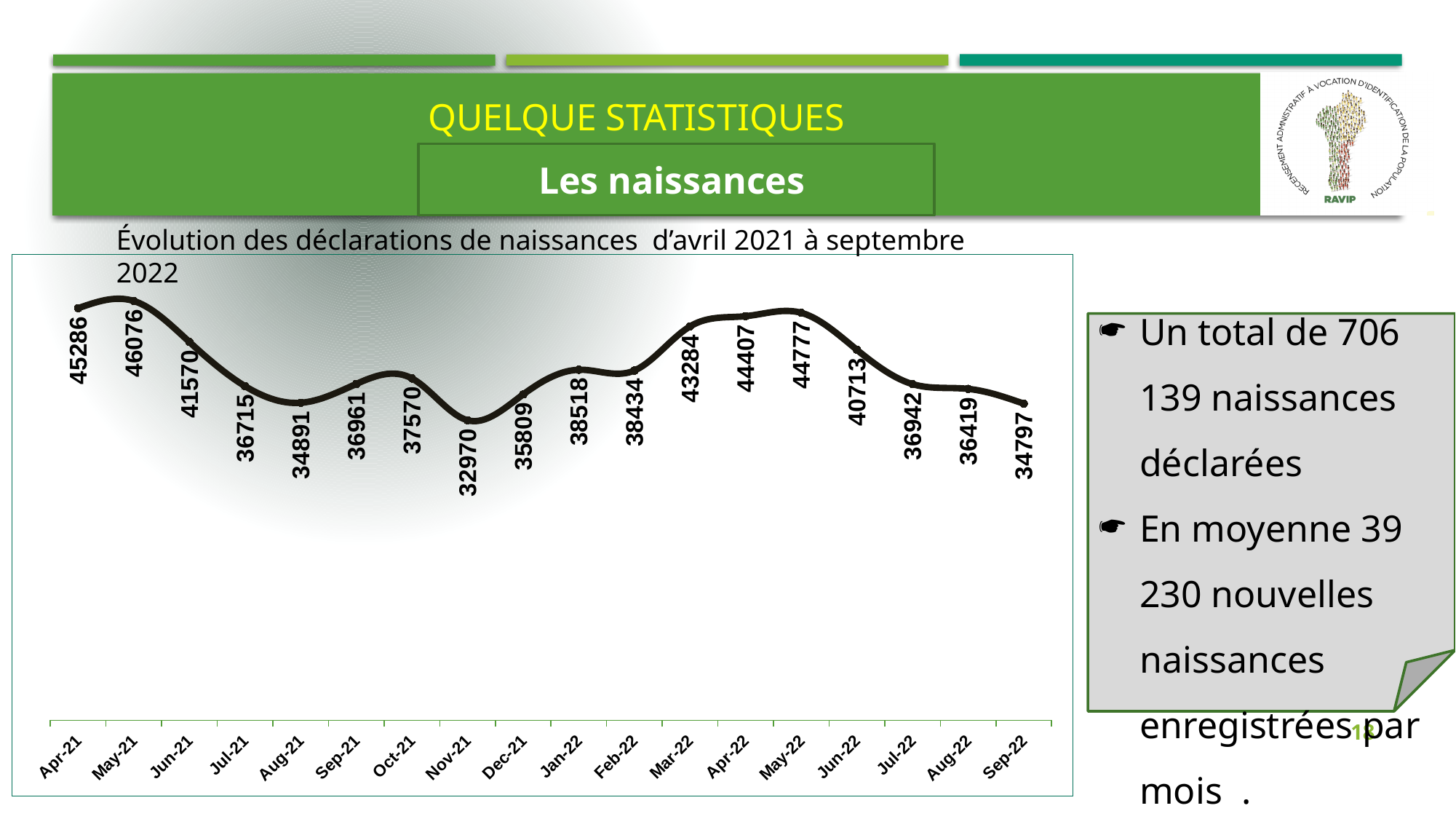
How many months are plotted on the chart? 18 What is the value for May-22? 44777 What type of chart is shown on the slide? line chart What is the value for Apr-21? 45286 What is the difference between the values for May-21 and Nov-21? 13106 What is the value for Sep-22? 34797 Which month has the highest value? May-21 Which is larger, the value for Jun-21 or the value for Jun-22? Jun-21 What is the value for Nov-21? 32970 Do the values rise or fall from Nov-21 to May-22? rise What is the difference between the values for Mar-22 and Feb-22? 4850 Which month has the lowest value? Nov-21